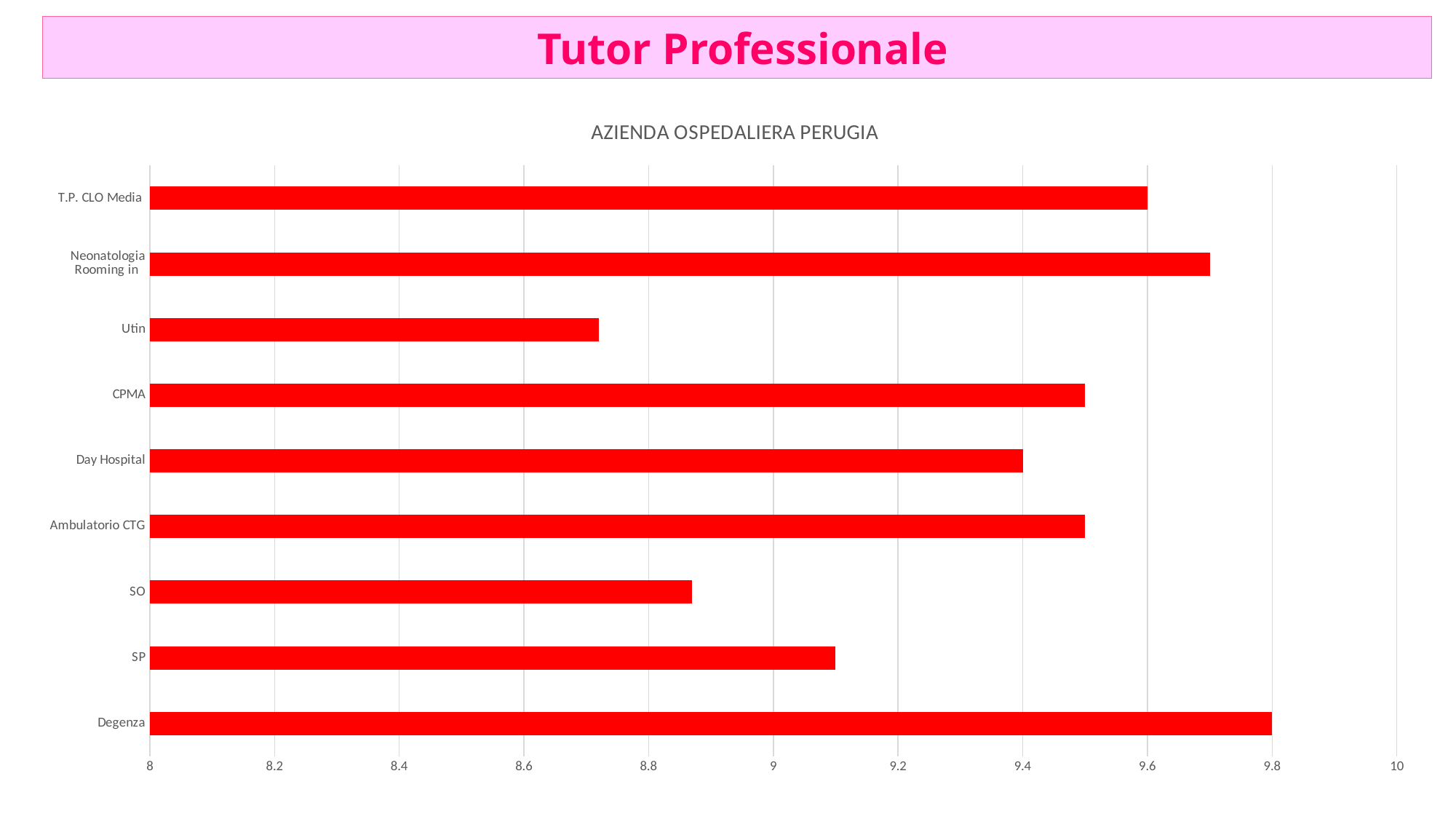
What type of chart is shown on the slide? bar chart Which category has the lowest value? Utin What is the value for Day Hospital? 9.4 Which category has the highest value? Degenza Which is larger, the value for Degenza or the value for SP? Degenza How many categories are plotted in the chart? 9 What is the title of the chart? AZIENDA OSPEDALIERA PERUGIA Is the value for Neonatologia Rooming in greater or less than 9.6? greater What is the value for Degenza? 9.8 What is the value for T.P. CLO Media? 9.6 Is the value for Utin greater or less than 8.8? less What is the difference between the values for Degenza and Day Hospital? 0.4